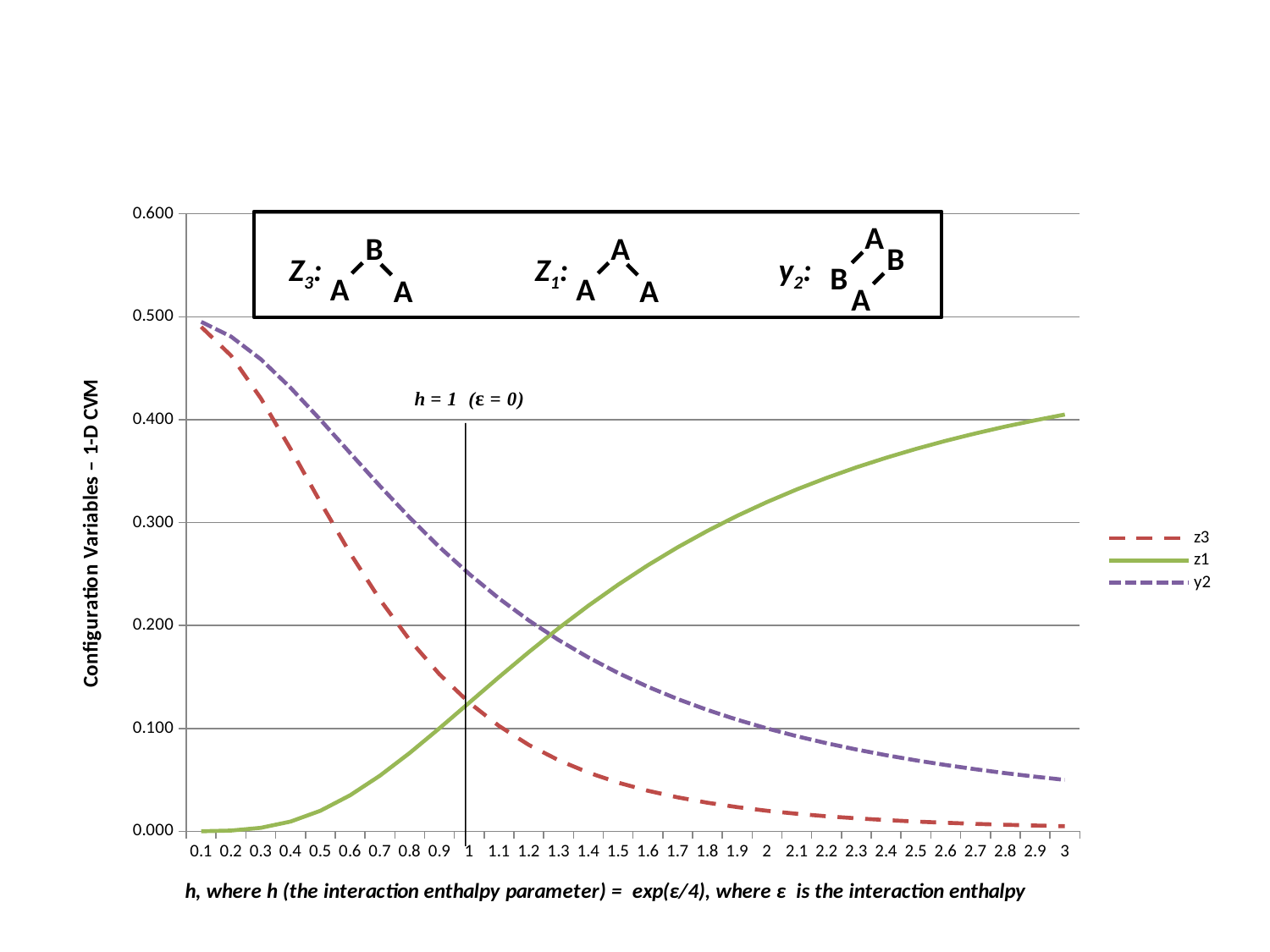
Is the value of z1 at h = 3 greater or less than 0.300? greater Is the value of y2 at h = 1 greater or less than 0.200? greater What is the title of the vertical (y) axis? Configuration Variables – 1-D CVM Does the z3 series rise or fall as h increases along the x axis? falls At h = 3, which series has the higher value, z1 or y2? z1 Does the y2 series rise or fall as h increases along the x axis? falls What kind of chart is shown on the slide? line chart How many series does the legend list? 3 Is the value of z1 at h = 0.5 greater or less than 0.100? less Does the z1 series rise or fall as h increases along the x axis? rises What are the series names listed in the legend? z3, z1, y2